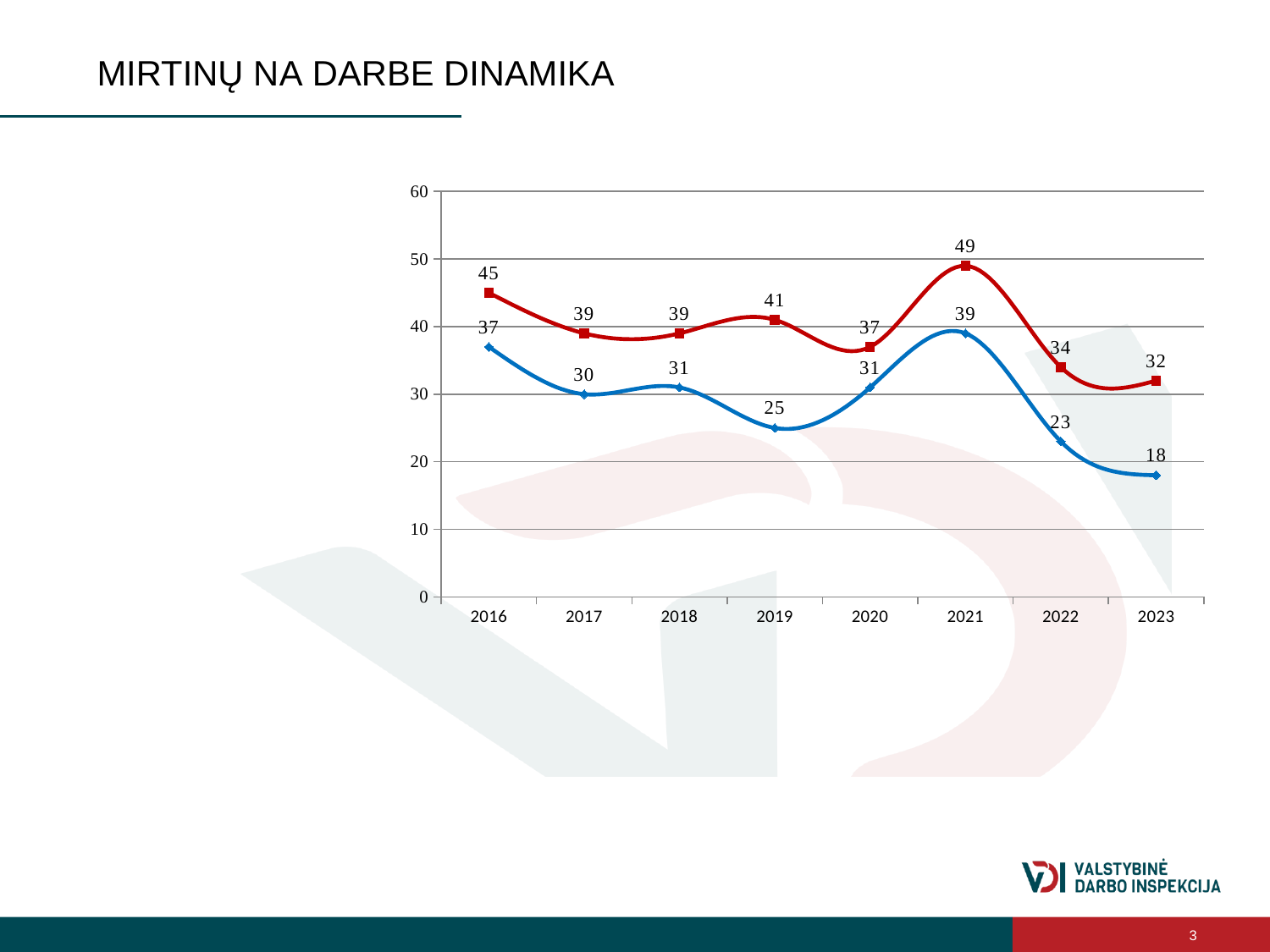
What is the value of the blue line in 2023? 18 In which year does the red line reach its highest value? 2021 What is the title of the slide containing the chart? MIRTINŲ NA DARBE DINAMIKA What type of chart is shown on the slide? line chart In which year does the blue line reach its lowest value? 2023 What is the value of the red line in 2021? 49 Which is larger: the red line value in 2019 or the red line value in 2020? 2019 What is the value of the blue line in 2019? 25 How many years are shown on the x axis? 8 Does the blue line rise or fall from 2021 to 2023? fall By how much did the blue line value fall from 2021 to 2022? 16 What is the difference between the red line and the blue line values in 2016? 8